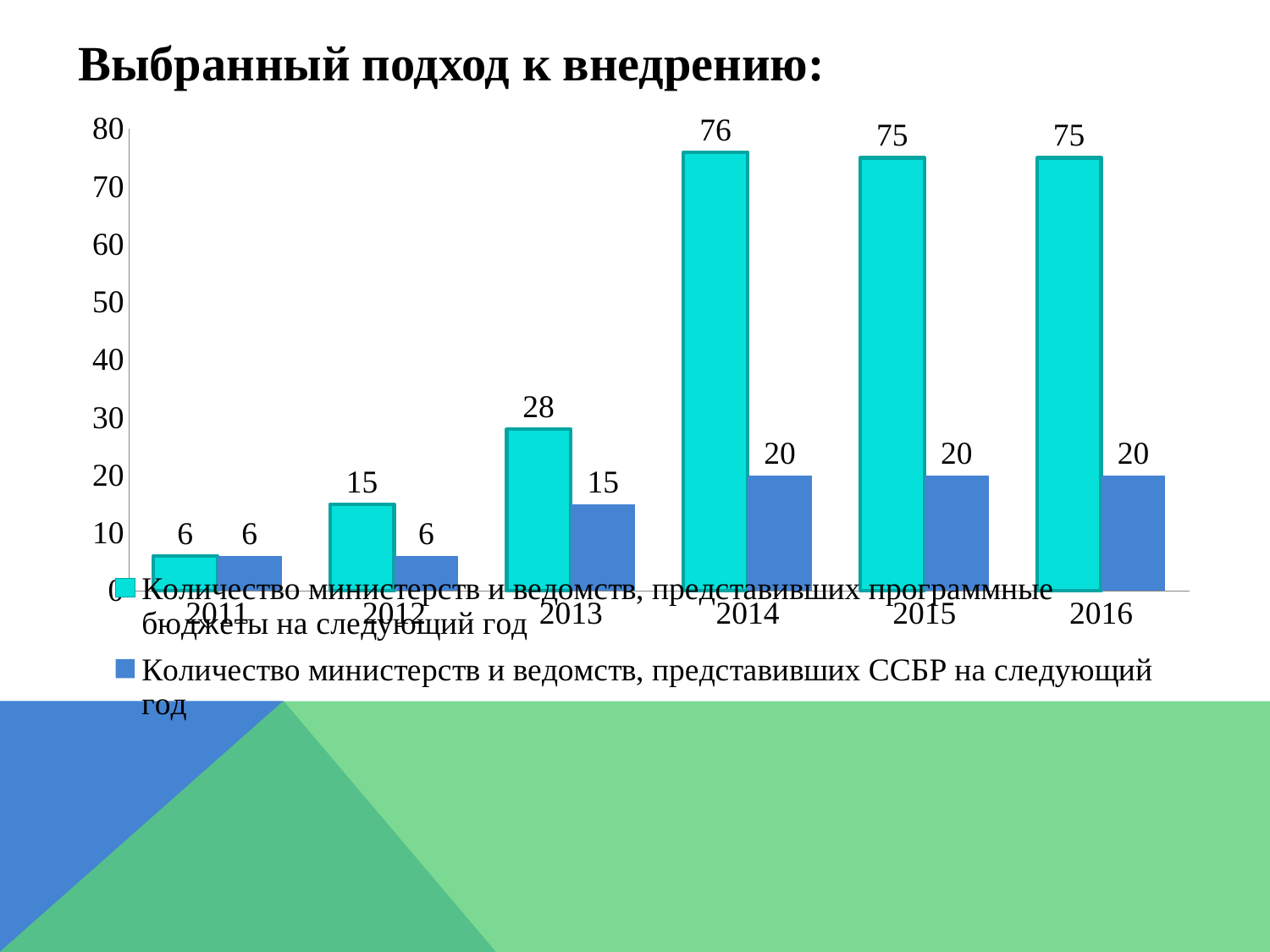
What is the value for 2013 in the series 'Количество министерств и ведомств, представивших ССБР на следующий год'? 15 Does the value for 'Количество министерств и ведомств, представивших ССБР на следующий год' rise or fall from 2011 to 2014? rise What is the value for 2014 in the series 'Количество министерств и ведомств, представивших программные бюджеты на следующий год'? 76 In 2012, which series has the larger value: 'программные бюджеты' or 'ССБР'? Количество министерств и ведомств, представивших программные бюджеты на следующий год What is the difference between the 2014 and 2013 values in the series 'Количество министерств и ведомств, представивших программные бюджеты на следующий год'? 48 How many years are shown on the x axis? 6 Which year has the highest value in the series 'Количество министерств и ведомств, представивших программные бюджеты на следующий год'? 2014 What colour are the bars for the series 'Количество министерств и ведомств, представивших ССБР на следующий год'? blue What type of chart is shown on the slide? bar chart What is the difference between the two series' values in 2013? 13 Which year has the lowest value in the series 'Количество министерств и ведомств, представивших программные бюджеты на следующий год'? 2011 How many series does the legend list? 2